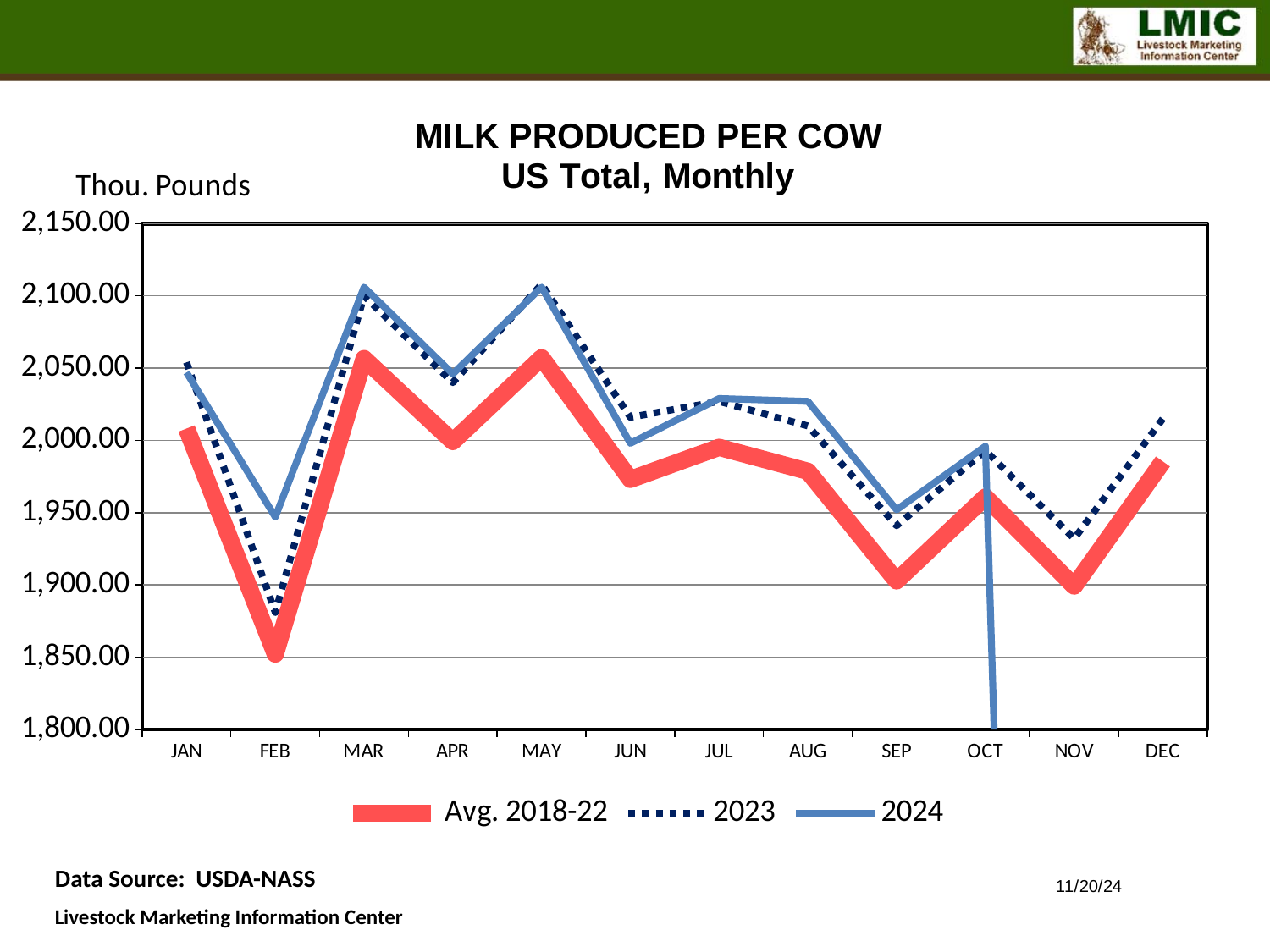
Is the 2024 value for JUL greater or less than 2,000.00? greater How many months are shown along the x axis? 12 How many series does the legend list? 3 Is the 2023 value for DEC greater or less than 2,000.00? greater In which month is the Avg. 2018-22 series at its lowest? FEB What kind of chart is shown on the slide? Line chart In FEB, which is larger: the 2024 value or the Avg. 2018-22 value? 2024 Is the Avg. 2018-22 value for FEB greater or less than 1,900.00? less In which month is the 2023 series at its lowest? FEB What is the title of the chart? MILK PRODUCED PER COW US Total, Monthly Does the Avg. 2018-22 series rise or fall from MAY to SEP? Fall What unit label is shown above the y axis? Thou. Pounds